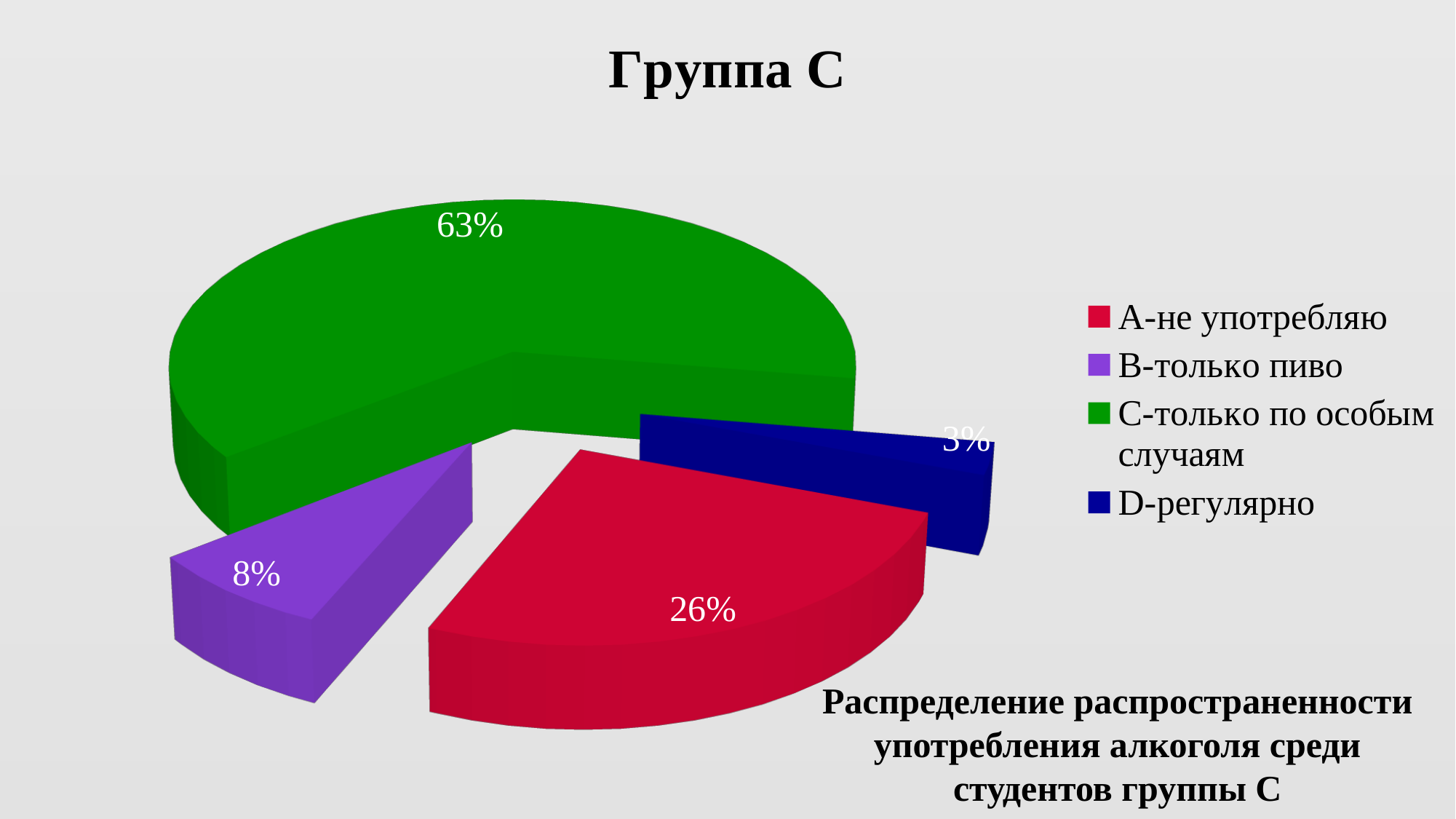
What is the chart's title? Группа С Which category has the smallest slice of the pie? D-регулярно What share of the pie does the slice for C-только по особым случаям have? 63% Which is larger, the share for B-только пиво or the share for D-регулярно? B-только пиво What share of the pie does the slice for A-не употребляю have? 26% What share of the pie does the slice for B-только пиво have? 8% How many categories does the pie chart have? 4 Which category has the largest slice of the pie? C-только по особым случаям What colour is the slice for A-не употребляю? red What kind of chart is shown on the slide? pie chart What is the difference between the shares for C-только по особым случаям and A-не употребляю? 37%